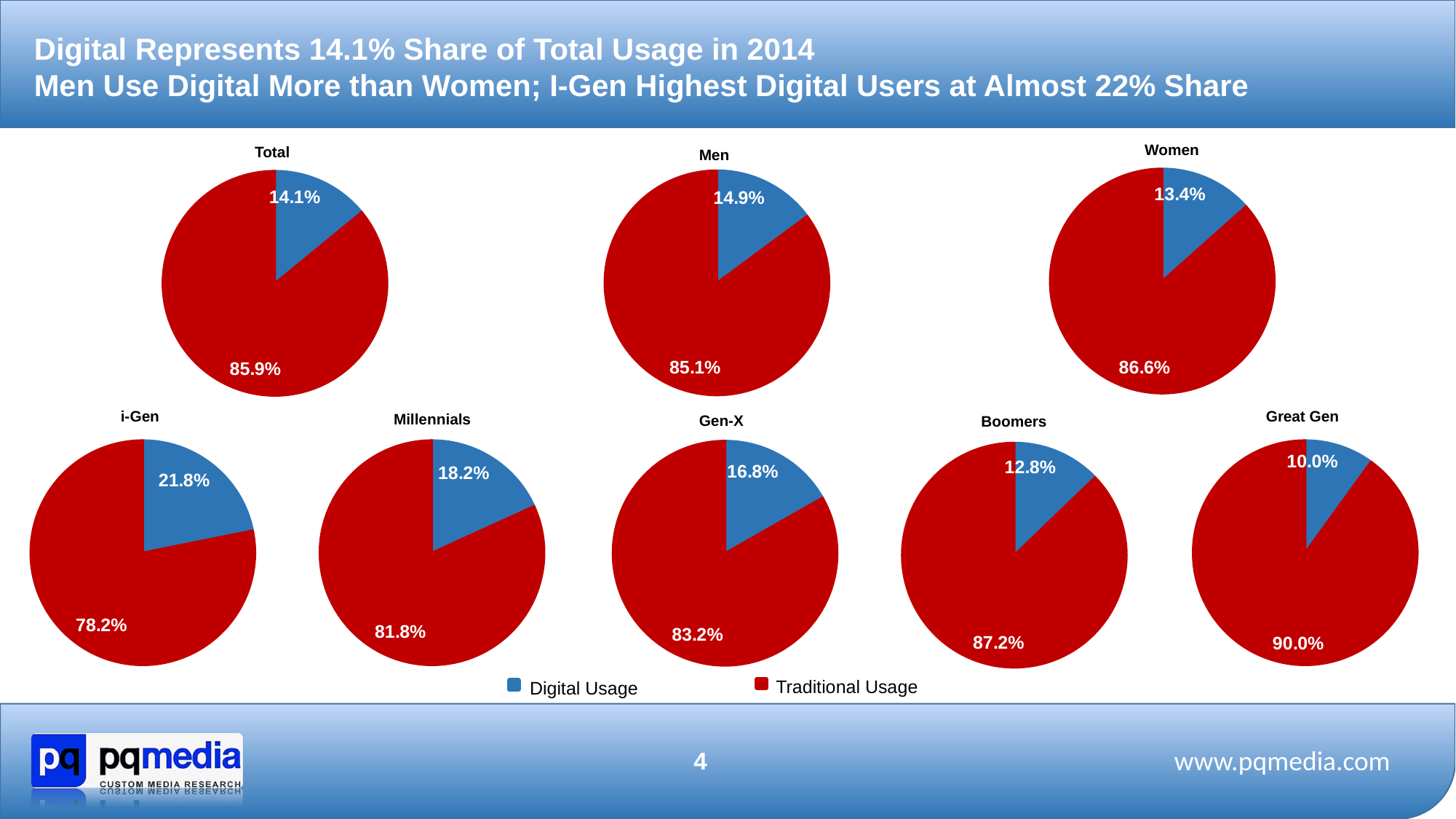
Is the Digital Usage share larger in the 'Millennials' chart or the 'Gen-X' chart? Millennials In the 'Boomers' pie chart, what is the share for Digital Usage? 12.8% In the 'Women' pie chart, what is the share for Digital Usage? 13.4% What is the difference between the Digital Usage share in the 'Men' chart and the 'Women' chart? 1.5% In the 'Total' pie chart, what is the share for Digital Usage? 14.1% Which pie chart on the slide shows the highest Digital Usage share? i-Gen In the 'i-Gen' pie chart, what is the share for Digital Usage? 21.8% Which pie chart on the slide shows the lowest Digital Usage share? Great Gen In the 'Great Gen' pie chart, what is the share for Traditional Usage? 90.0% How many series does the legend list? 2 What kind of charts are shown on the slide? Pie charts In the 'Men' pie chart, what is the share for Traditional Usage? 85.1%